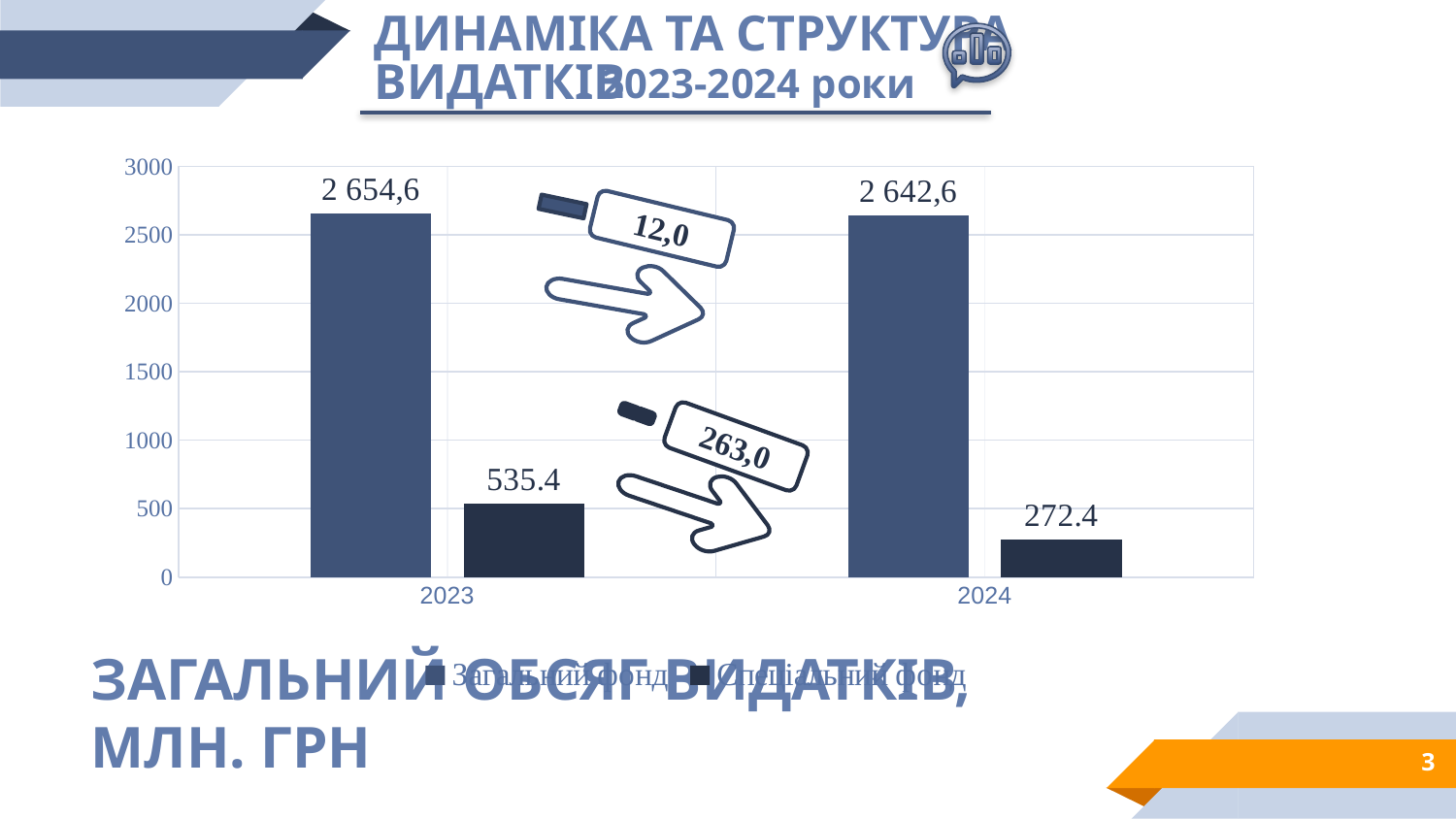
By how much did Спеціальний фонд decrease from 2023 to 2024? 263,0 Which year has the larger value for Спеціальний фонд, 2023 or 2024? 2023 What is the value of Спеціальний фонд for 2023? 535.4 What is the value of Загальний фонд for 2024? 2 642,6 How many series does the legend list? 2 What is the value of Спеціальний фонд for 2024? 272.4 What is the value of Загальний фонд for 2023? 2 654,6 How many years (categories) are shown on the x axis? 2 What kind of chart is shown on the slide? bar chart By how much did Загальний фонд decrease from 2023 to 2024? 12,0 In which year is the Загальний фонд value highest? 2023 Do the Спеціальний фонд values rise or fall from 2023 to 2024? fall